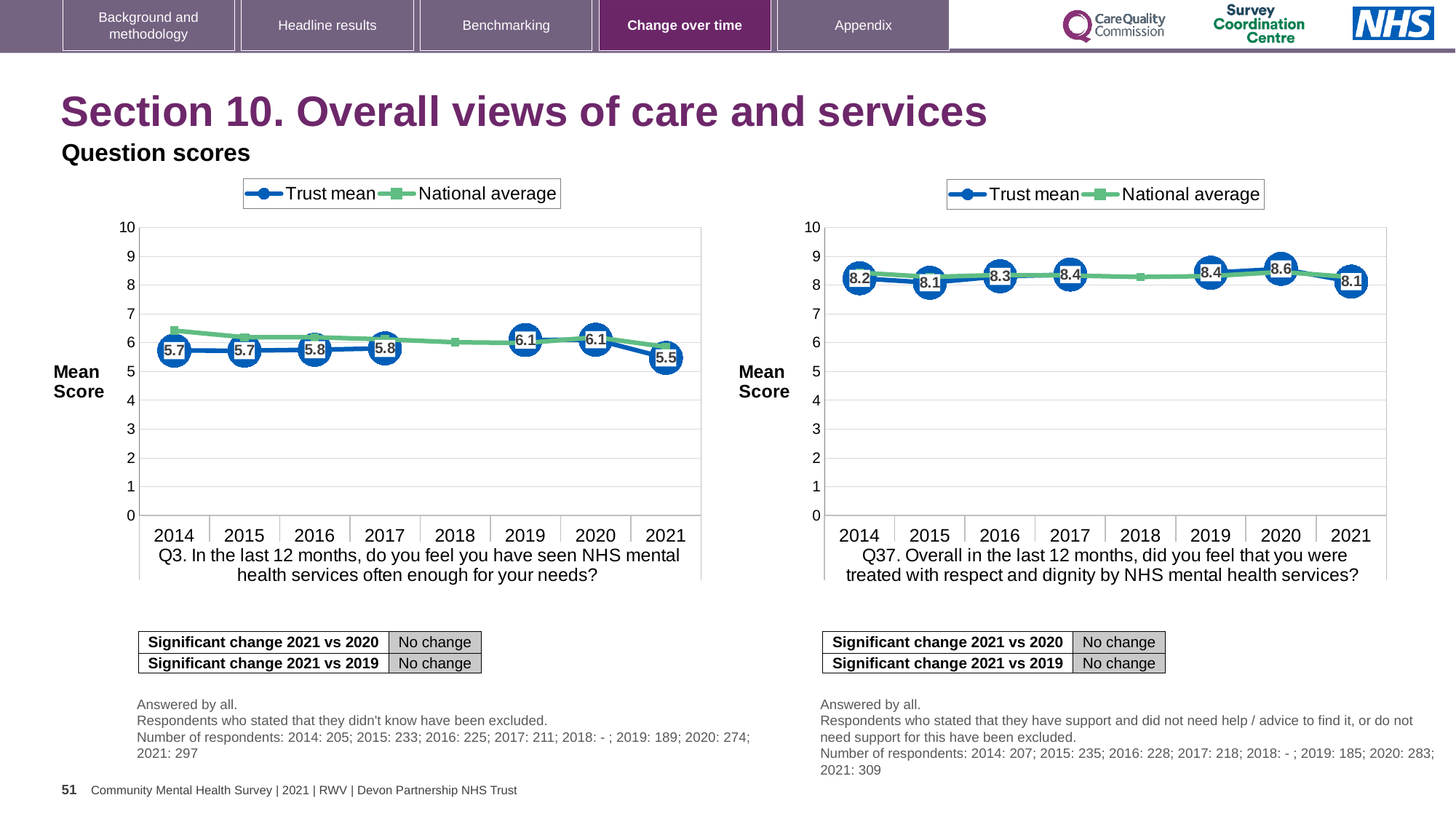
In the left chart (Q3), is the National average for 2014 greater or less than 6? greater In the left chart (Q3), which year has the lowest Trust mean score? 2021 In the right chart (Q37), what is the Trust mean score for 2020? 8.6 How many years are shown on the x axis of the left chart (Q3)? 8 How many series does the legend of the right chart (Q37) list? 2 In the left chart (Q3), what is the Trust mean score for 2021? 5.5 In the left chart (Q3), what is the Trust mean score for 2019? 6.1 What kind of chart is the left chart (Q3)? Line chart In the right chart (Q37), which year has the highest Trust mean score? 2020 In the left chart (Q3), what is the difference between the Trust mean scores for 2020 and 2021? 0.6 In the right chart (Q37), what is the Trust mean score for 2014? 8.2 In the right chart (Q37), which is larger, the Trust mean score for 2017 or for 2021? 2017